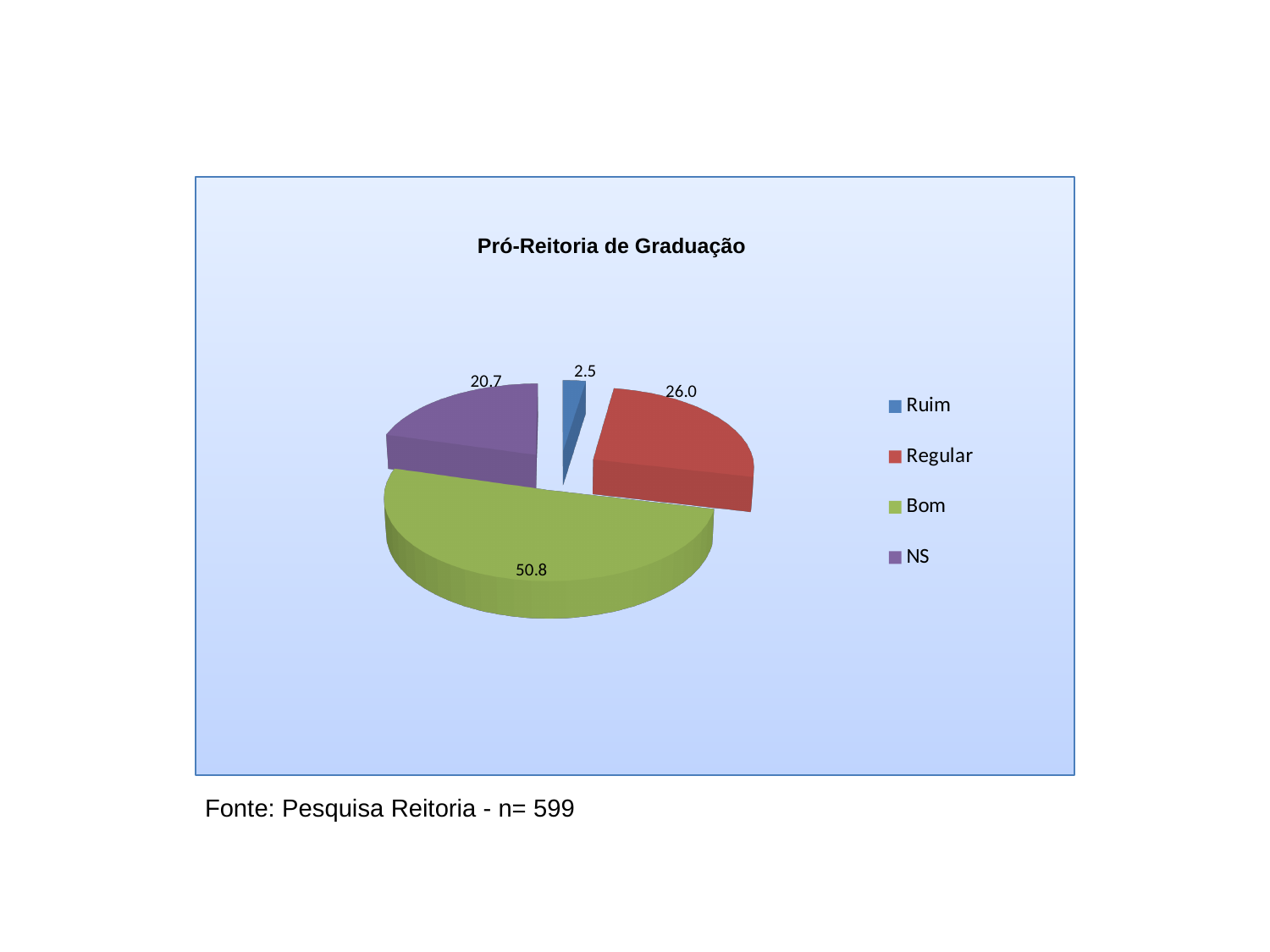
What is the difference between the values for Bom and Regular? 24.8 What is the value for NS? 20.7 Which category has the smallest slice? Ruim Which is larger, the value for Regular or the value for NS? Regular Which category has the largest slice? Bom What is the value for Bom? 50.8 What is the value for Regular? 26.0 What is the value for Ruim? 2.5 What is the title of the chart? Pró-Reitoria de Graduação What is the difference between the values for Regular and NS? 5.3 What kind of chart is shown on the slide? Pie chart How many categories does the pie chart show? 4